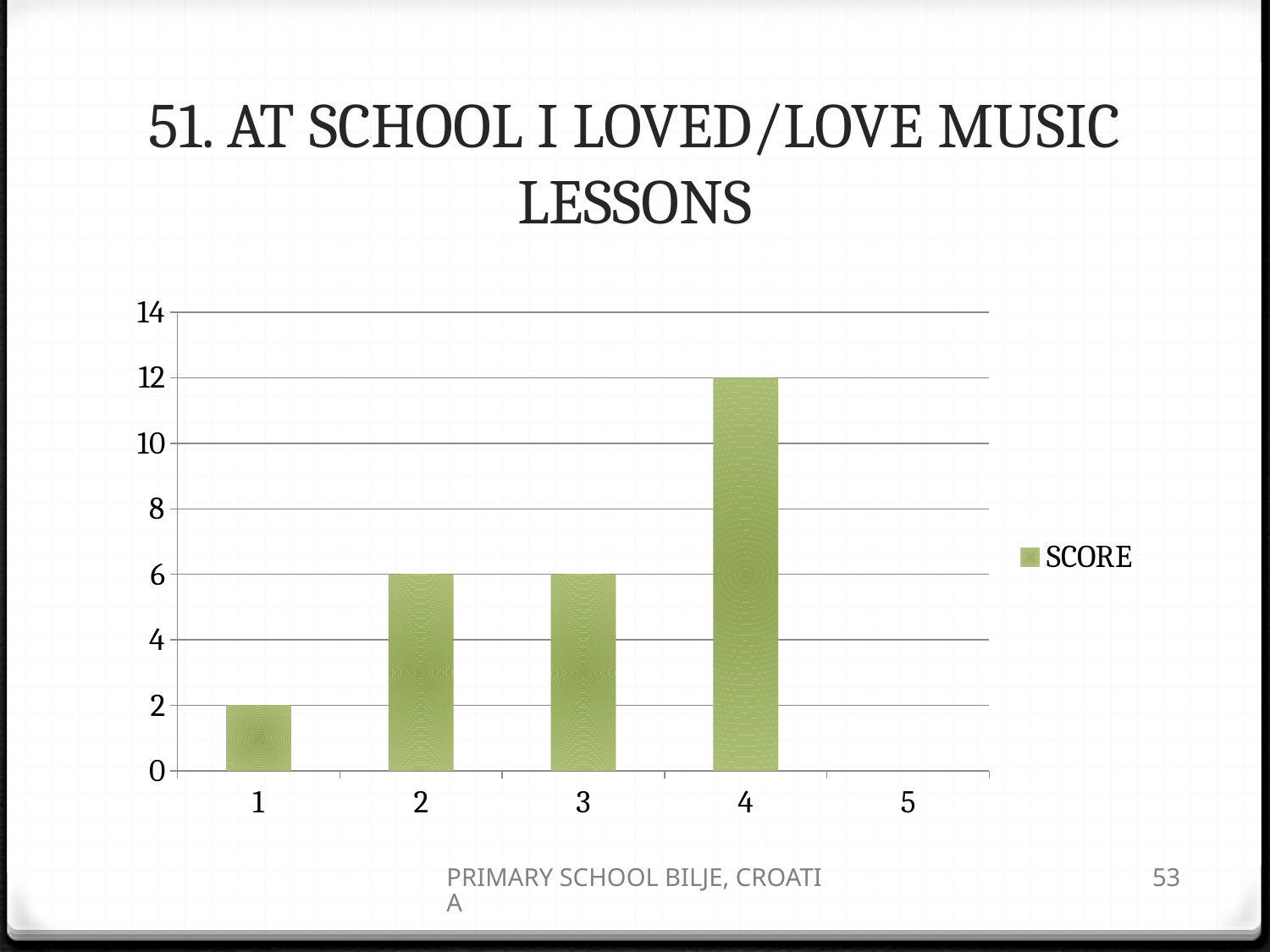
What is the value for category 4? 12 Which category has the highest value? 4 Which is larger, the value for category 3 or the value for category 4? 4 What type of chart is shown on the slide? bar chart What is the name of the series shown in the legend? SCORE What is the value for category 1? 2 How many categories are shown on the x axis? 5 How many series does the legend list? 1 Which category has the lowest value? 5 Is the value for category 4 greater or less than 10? greater What is the difference between the values for category 4 and category 1? 10 What is the value for category 2? 6